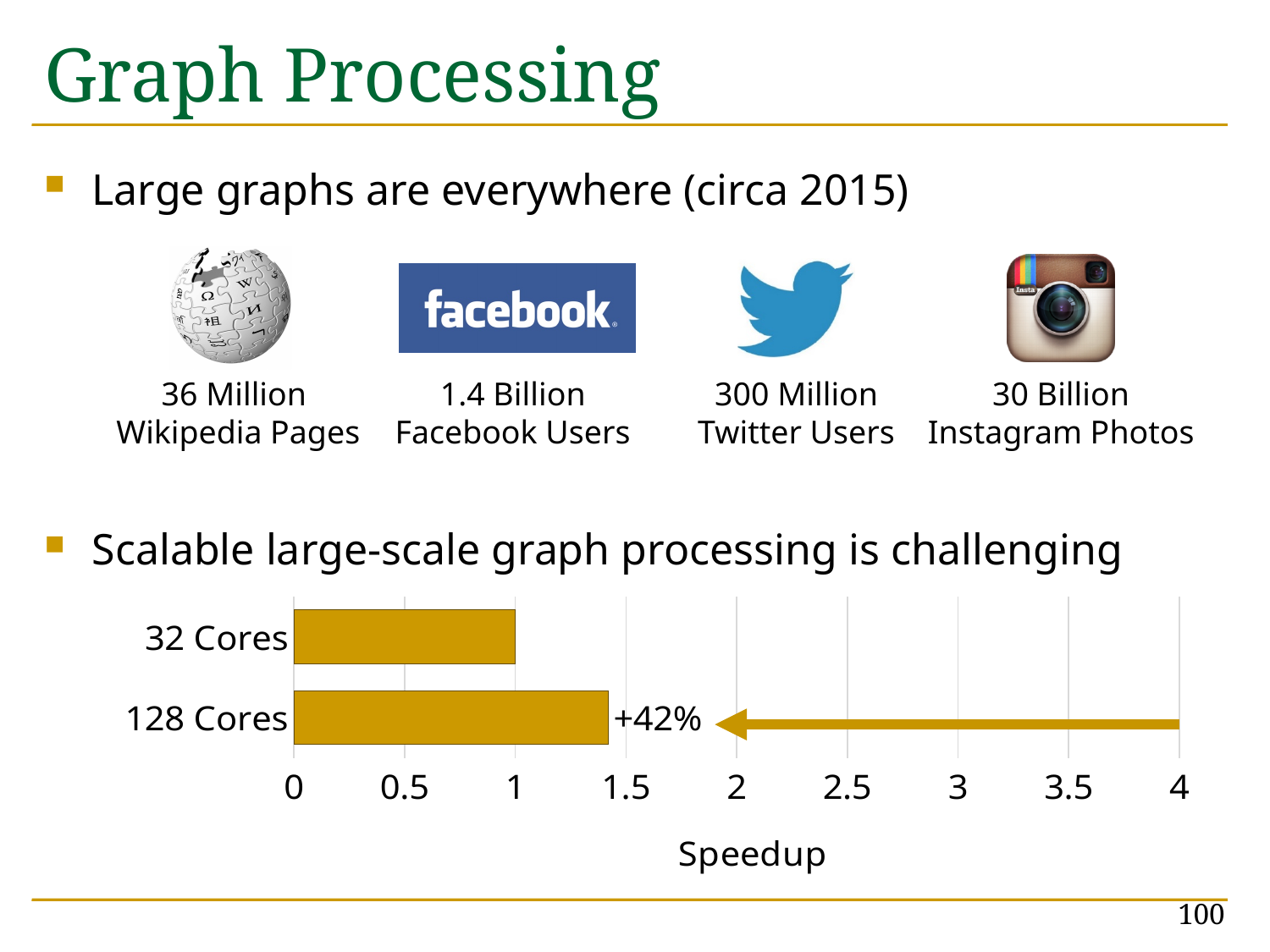
Which is larger, the speedup for 32 Cores or for 128 Cores? 128 Cores Which category has the highest speedup? 128 Cores What is the maximum value shown on the x axis of the bar chart? 4 How many categories does the bar chart show? 2 Is the speedup for 128 Cores greater or less than 1.5? less Is the speedup for 128 Cores greater or less than 1? greater What is the speedup value for 32 Cores? 1 Which category has the lowest speedup? 32 Cores What percentage annotation is shown next to the 128 Cores bar? +42% What is the label of the x axis of the bar chart? Speedup Is the speedup for 128 Cores greater or less than 2? less What kind of chart is shown on the slide? bar chart